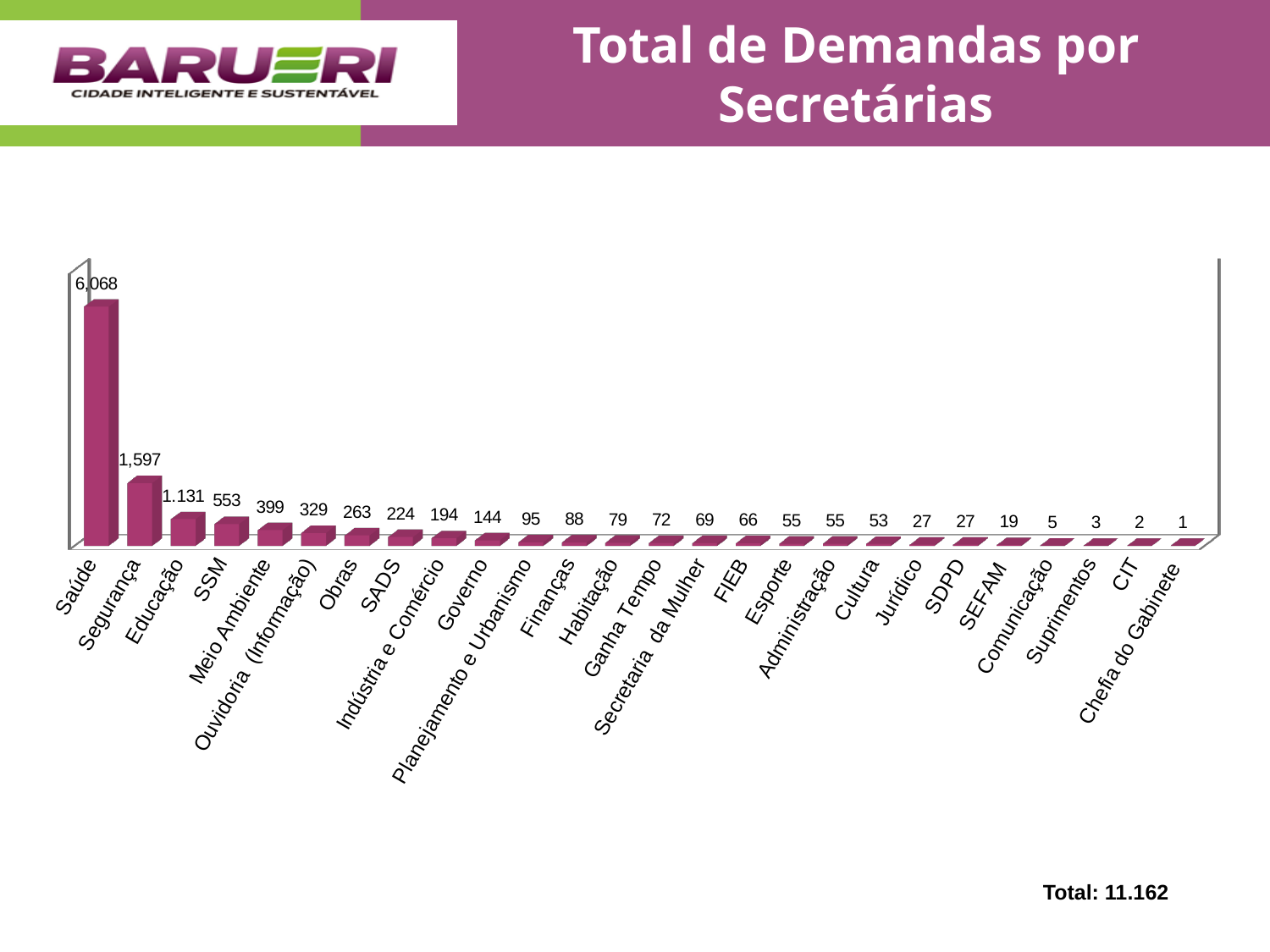
What is the difference between the values for SSM and Obras? 290 What is the value for SEFAM? 19 What is the value for Governo? 144 What is the title of the chart? Total de Demandas por Secretárias Which category has the highest value? Saúde What kind of chart is shown on the slide? Bar chart What is the value for Segurança? 1,597 What is the value for Saúde? 6,068 How many categories are shown on the chart? 26 Which is larger, the value for Habitação or the value for Finanças? Finanças Which category has the lowest value? Chefia do Gabinete What is the value for Meio Ambiente? 399